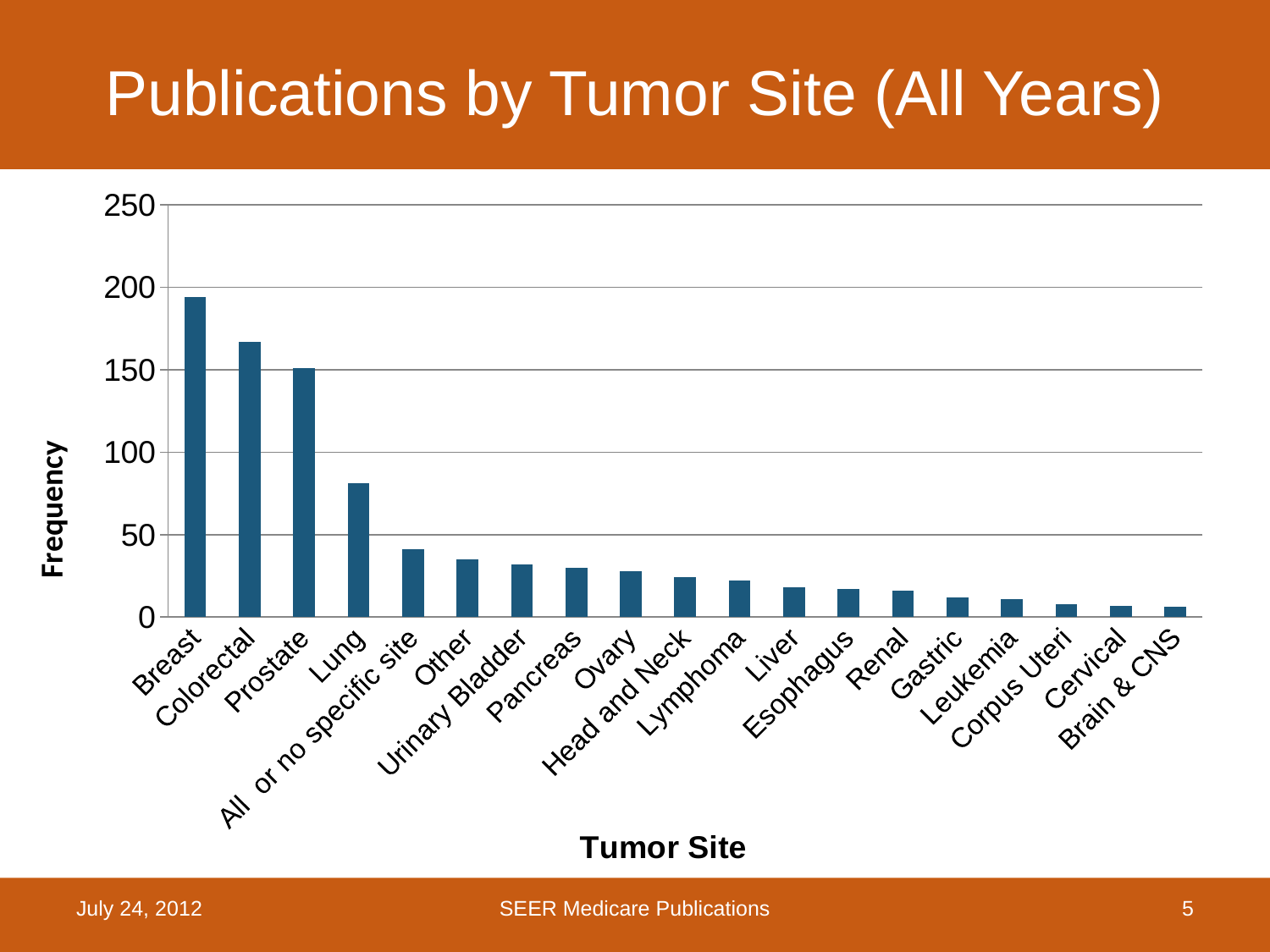
Which tumor site has the highest frequency of publications? Breast How many tumor site categories are plotted on the x axis? 19 Is the value for Brain & CNS greater or less than 50? less Which has a higher frequency, Lung or Breast? Breast Do the values rise or fall moving from left to right along the x axis? fall Is the value for Lung greater or less than 50? greater Is the value for Colorectal greater or less than 150? greater Which has a higher frequency, Colorectal or Prostate? Colorectal What is the label on the y axis of the chart? Frequency What kind of chart is shown on the slide? bar chart